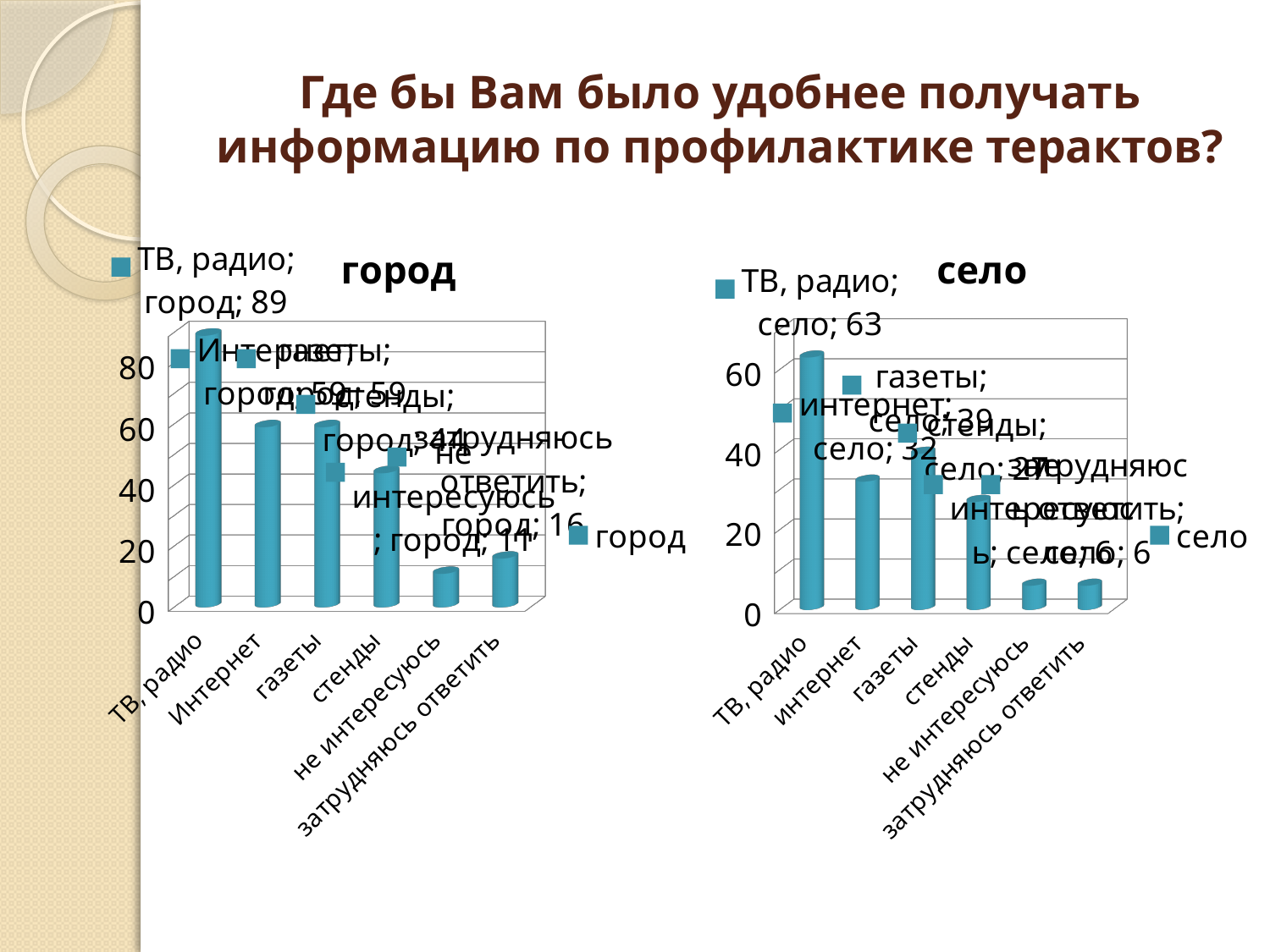
In the "город" chart, which is larger: не интересуюсь or затрудняюсь ответить? затрудняюсь ответить In the "село" chart, what is the value for интернет? 32 In the "город" chart, which category has the highest value? ТВ, радио In the "город" chart, what is the value for затрудняюсь ответить? 16 In the "село" chart, what is the value for ТВ, радио? 63 What type of chart is the "город" chart? bar chart In the "город" chart, what is the value for ТВ, радио? 89 In the "город" chart, which category has the lowest value? не интересуюсь In the "село" chart, is the value for газеты greater or less than 20? greater In the "село" chart, what is the difference between the values for ТВ, радио and интернет? 31 How many categories are shown on the x axis of the "село" chart? 6 In the "село" chart, is the value for стенды greater or less than 40? less